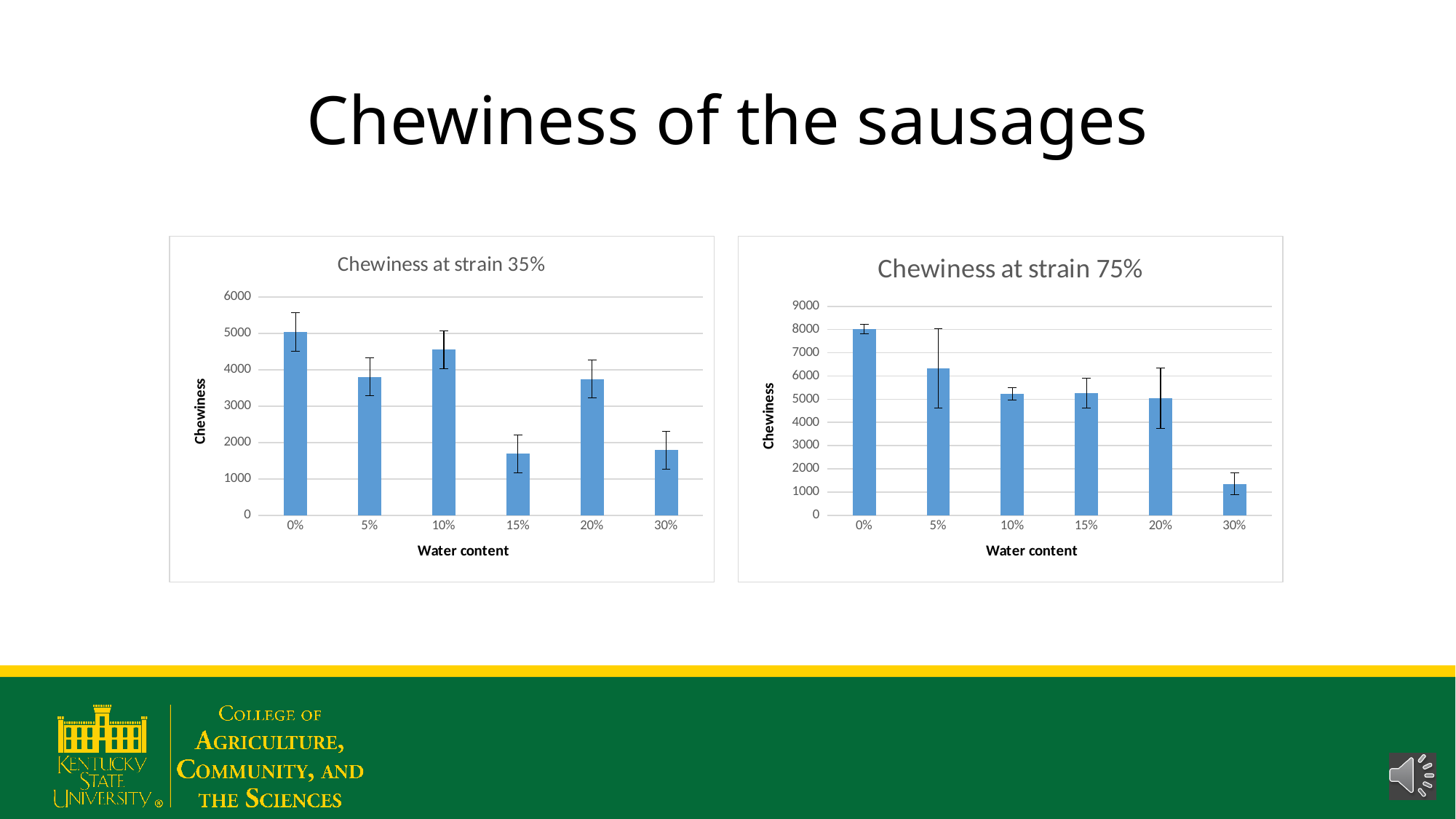
In the chart titled "Chewiness at strain 35%", which is larger, the chewiness at 10% water content or at 5% water content? 10% In the chart titled "Chewiness at strain 75%", which water content has the lowest chewiness? 30% In the chart titled "Chewiness at strain 75%", which water content has the highest chewiness? 0% In the chart titled "Chewiness at strain 35%", which water content has the highest chewiness? 0% In the chart titled "Chewiness at strain 35%", is the chewiness at 15% water content greater or less than 2000? less In the chart titled "Chewiness at strain 35%", how many water content categories are plotted? 6 In the chart titled "Chewiness at strain 35%", what kind of chart is shown? Bar chart In the chart titled "Chewiness at strain 75%", is the chewiness at 30% water content greater or less than 2000? less In the chart titled "Chewiness at strain 75%", what is the label on the x axis? Water content What is the title of the chart on the left side of the slide? Chewiness at strain 35% In the chart titled "Chewiness at strain 75%", is the chewiness at 5% water content greater or less than 6000? greater